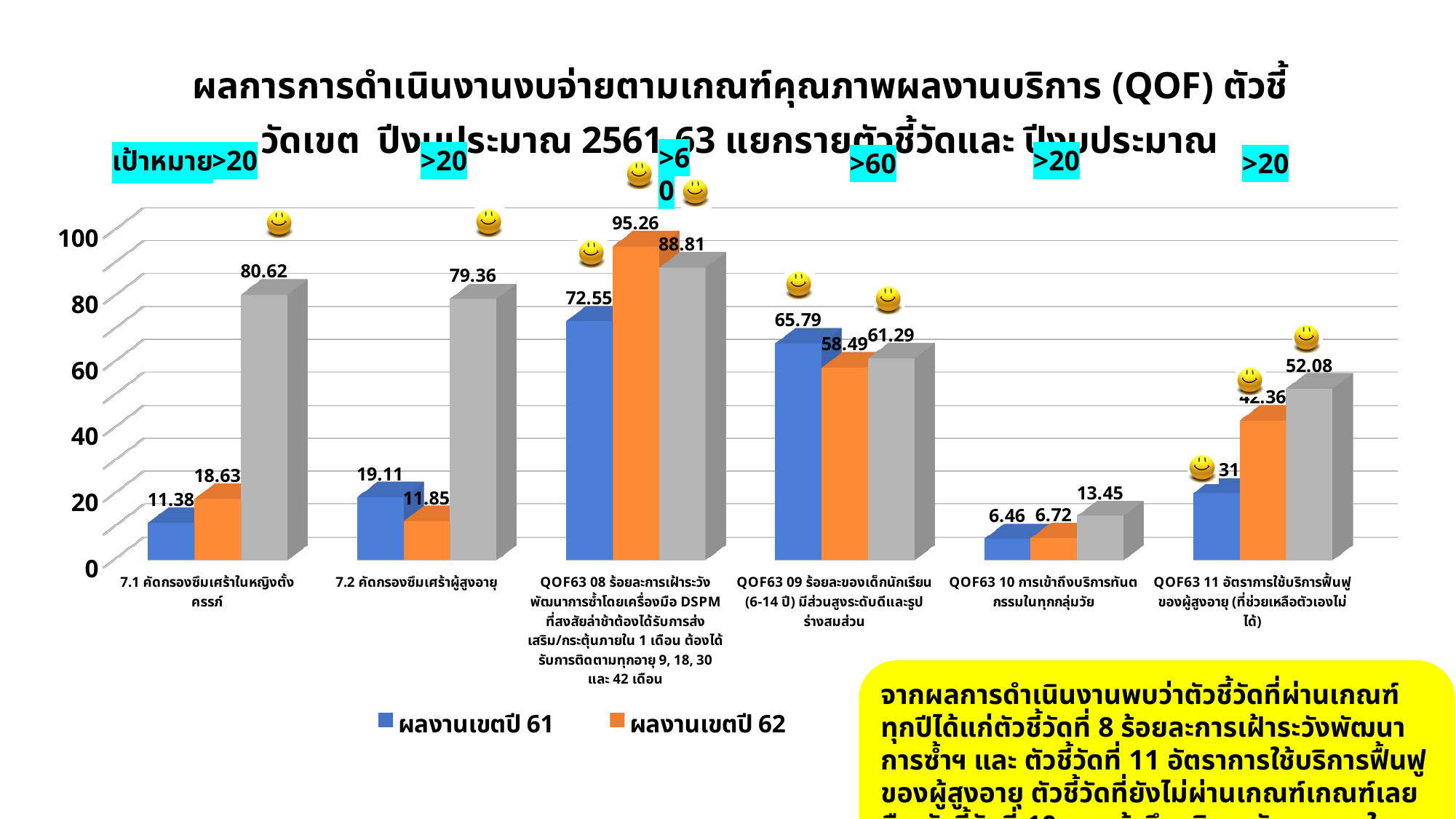
Which category has the lowest value for ผลงานเขตปี 61? QOF63 10 การเข้าถึงบริการทันตกรรมในทุกกลุ่มวัย What colour represents ผลงานเขตปี 62 in the chart? orange What is the value of ผลงานเขตปี 61 for the category QOF63 09 (ร้อยละของเด็กนักเรียน 6-14 ปี มีส่วนสูงระดับดีและรูปร่างสมส่วน)? 65.79 Which category has the highest value for ผลงานเขตปี 62? QOF63 08 ร้อยละการเฝ้าระวังพัฒนาการซ้ำโดยเครื่องมือ DSPM For the category QOF63 09, which is larger: ผลงานเขตปี 61 or ผลงานเขตปี 62? ผลงานเขตปี 61 What type of chart is shown on the slide? bar chart What is the value of ผลงานเขตปี 62 for the category 7.2 คัดกรองซึมเศร้าผู้สูงอายุ? 11.85 What is the value of ผลงานเขตปี 62 for the category QOF63 08 (ร้อยละการเฝ้าระวังพัฒนาการซ้ำโดยเครื่องมือ DSPM)? 95.26 How many categories are shown on the x axis of the chart? 6 Is the value of ผลงานเขตปี 62 for the category QOF63 10 greater or less than 20? less What is the difference between ผลงานเขตปี 62 and ผลงานเขตปี 61 for the category QOF63 08? 22.71 What is the value of ผลงานเขตปี 61 for the category 7.1 คัดกรองซึมเศร้าในหญิงตั้งครรภ์? 11.38